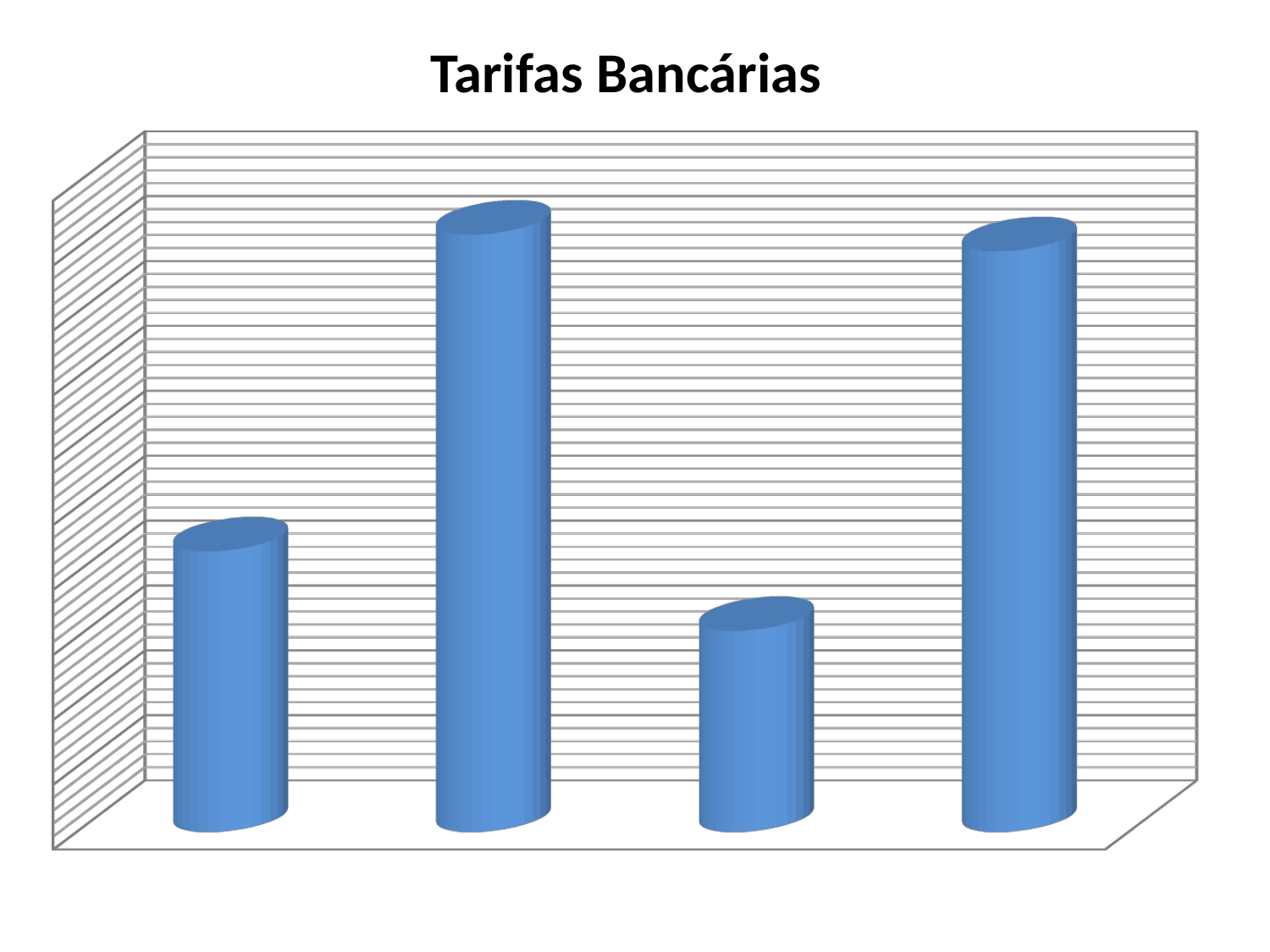
What is the title of the chart? Tarifas Bancárias What colour are the bars in the chart? blue Which is larger, the fourth bar from the left or the first bar from the left? the fourth bar What kind of chart is shown on the slide? bar chart How many bars are plotted in the chart? 4 Which is larger, the first bar from the left or the third bar from the left? the first bar Which bar, counting from the left, is the lowest in the chart? the third bar Which is larger, the second bar from the left or the third bar from the left? the second bar